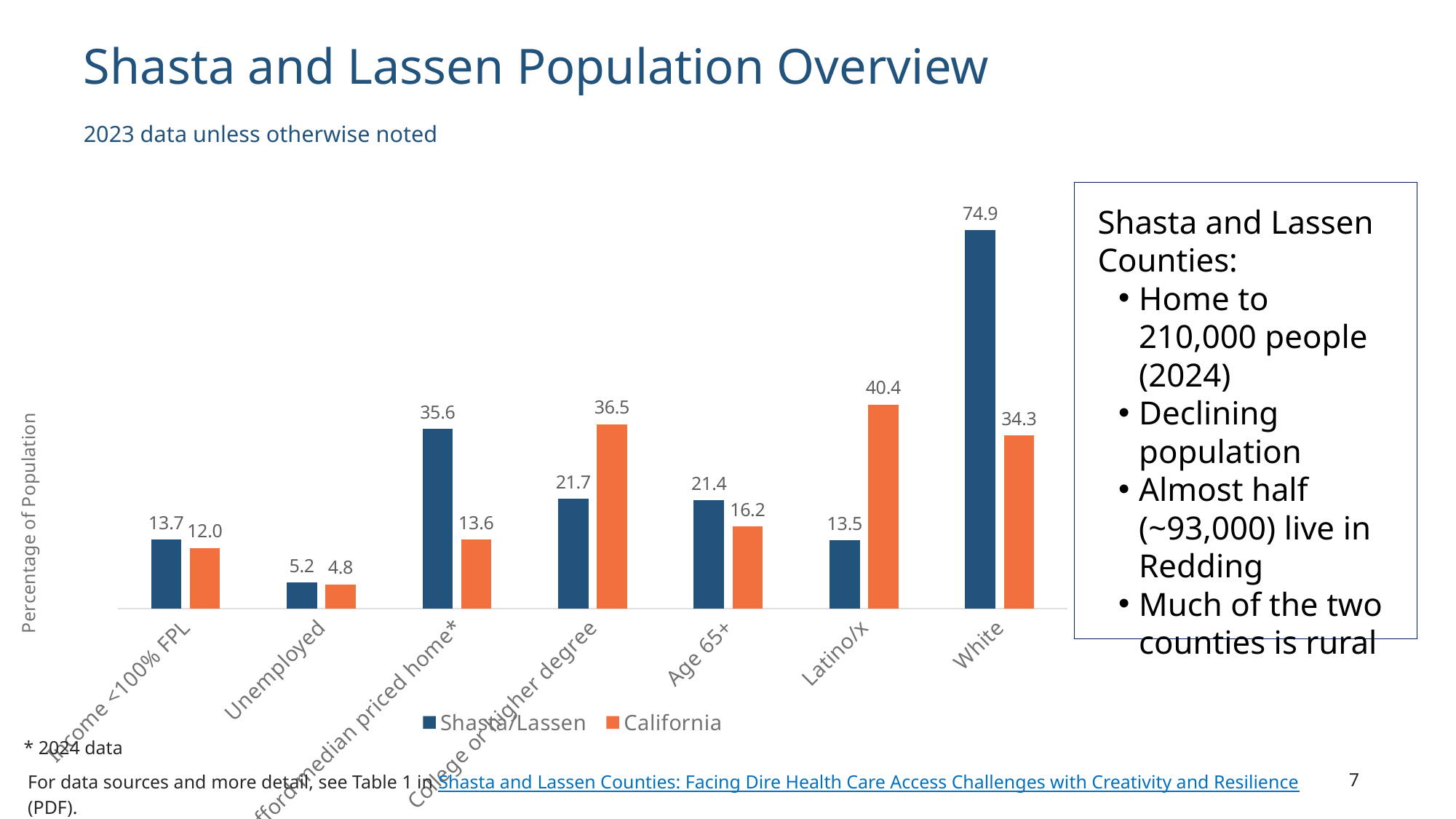
What is the Shasta/Lassen value for Age 65+? 21.4 What is the label of the vertical axis? Percentage of Population Which category has the lowest California value? Unemployed Which category has the highest Shasta/Lassen value? White What is the California value for Unemployed? 4.8 How many categories are shown on the x axis? 7 What kind of chart is shown on the slide? Bar chart What is the Shasta/Lassen value for White? 74.9 For Latino/x, which series has the larger value, Shasta/Lassen or California? California What is the difference between the Shasta/Lassen and California values for College or higher degree? 14.8 What is the California value for Latino/x? 40.4 How many series does the legend list? 2